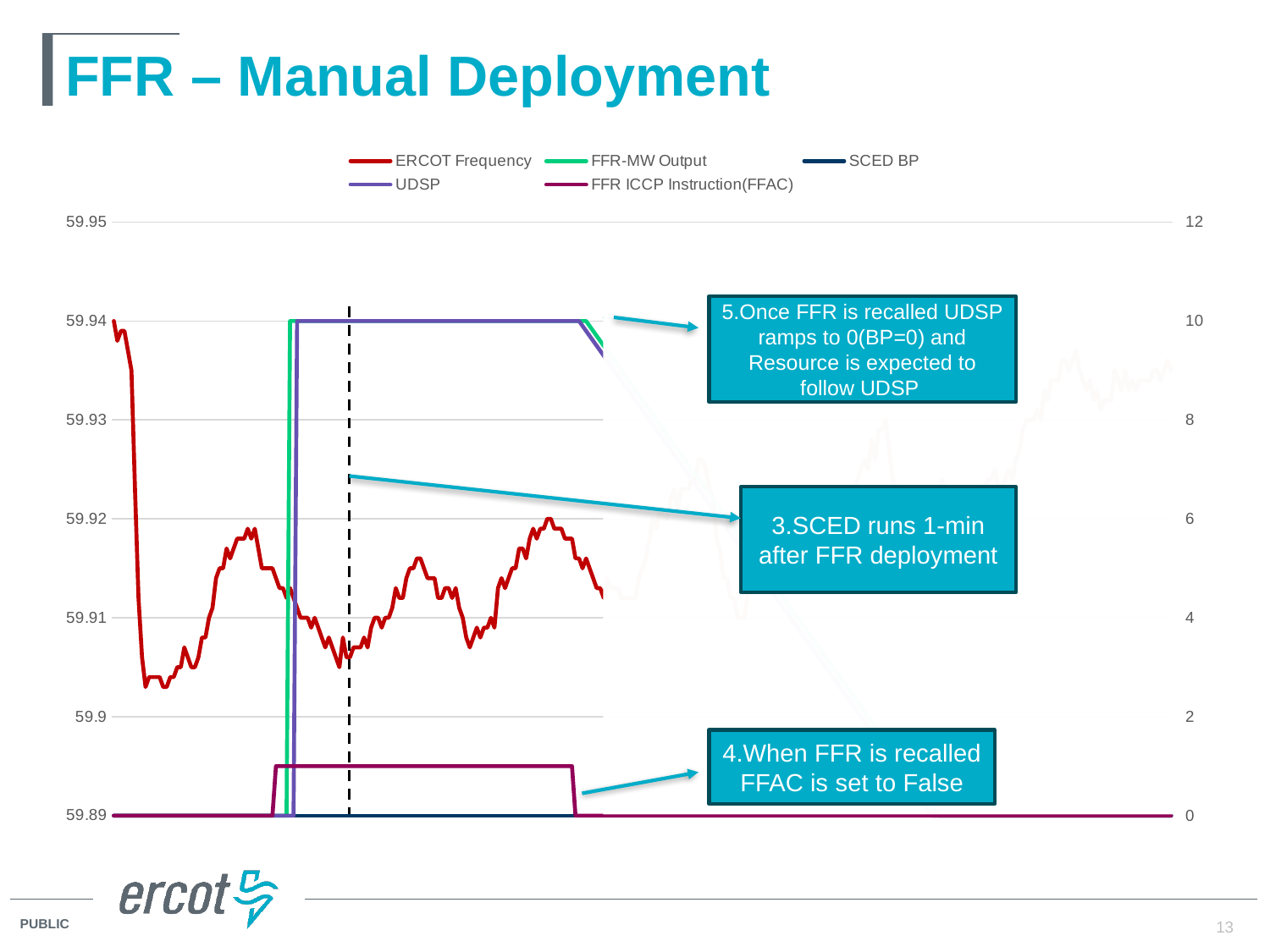
Is the plateau value of the FFR ICCP Instruction(FFAC) series greater or less than 2 on the right axis? less What is the highest value shown on the right vertical axis? 12 What is the highest value shown on the left vertical axis? 59.95 Does the ERCOT Frequency series rise or fall at the very start of the chart? fall What is the title of the slide containing the chart? FFR – Manual Deployment How many series does the chart legend list? 5 What kind of chart is shown on the slide? line chart Is the lowest value of the ERCOT Frequency series greater or less than 59.91 on the left axis? less Is the plateau value of the UDSP series greater or less than 8 on the right axis? greater Which series has the higher plateau on the right axis, UDSP or FFR ICCP Instruction(FFAC)? UDSP